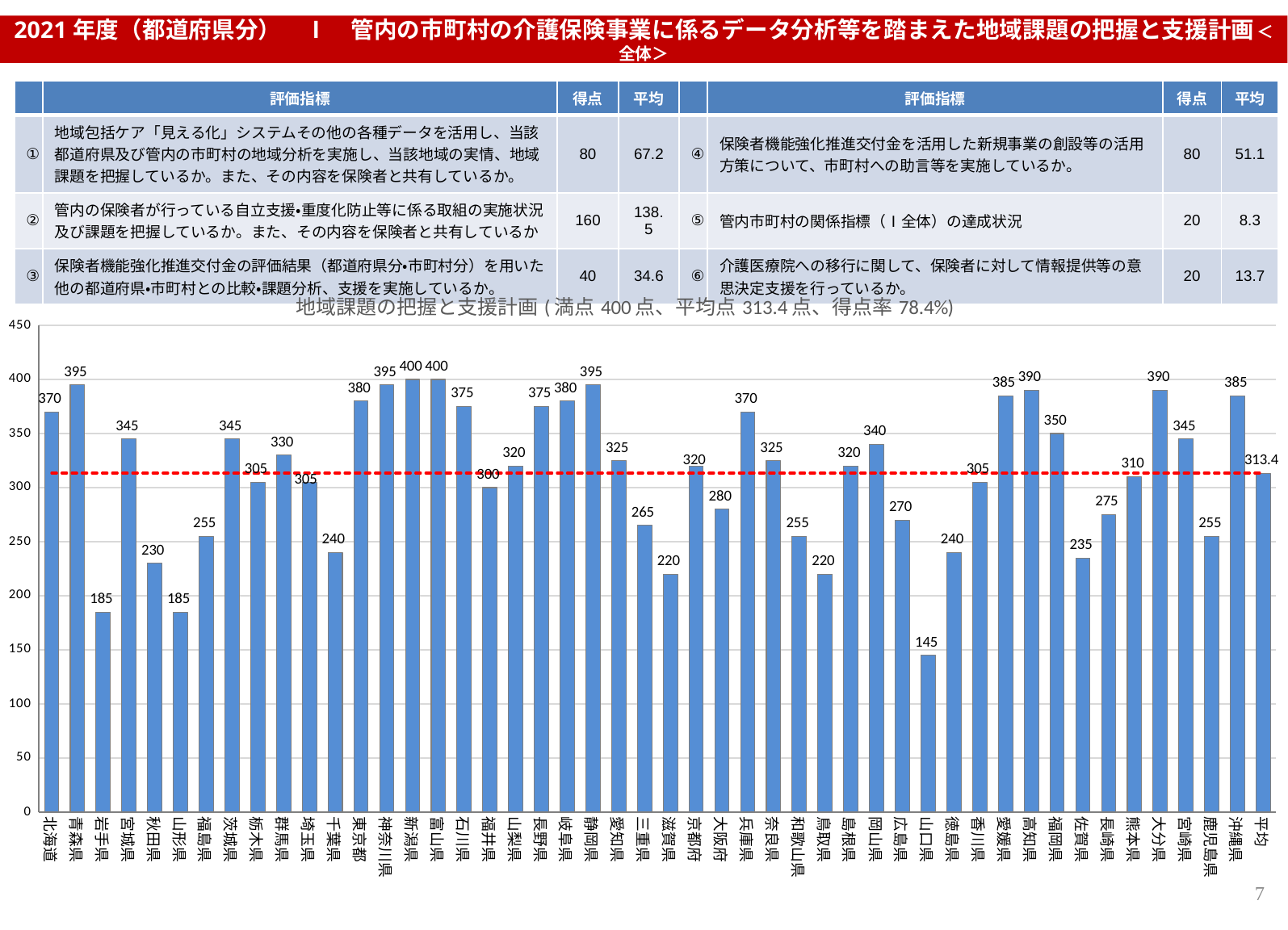
How many bars are plotted in the chart, including the 平均 bar? 48 Which has a larger value, 東京都 or 大阪府? 東京都 What is the value for 北海道 in the chart? 370 What is the value shown for the 平均 bar at the far right of the chart? 313.4 What is the difference between the values for 青森県 and 岩手県? 210 What is the difference between the values for 新潟県 and 福井県? 100 Which category has the lowest value in the chart? 山口県 According to the chart title, what is the 得点率? 78.4% What is the value for 沖縄県 in the chart? 385 Is the value for 滋賀県 greater or less than 250? less What is the value for 山口県 in the chart? 145 What kind of chart is shown on the slide? bar chart